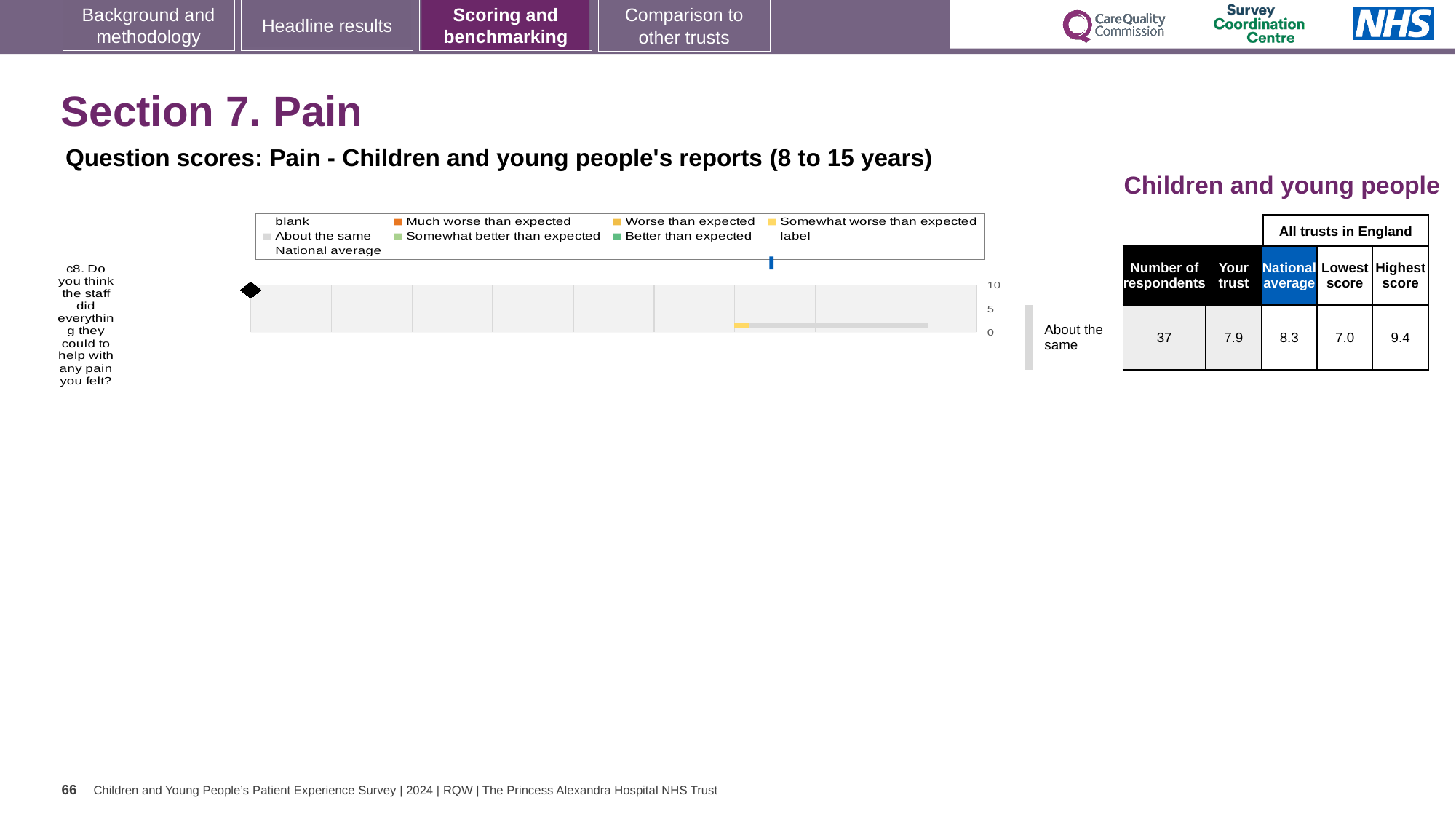
According to the table beside the chart, what is the lowest score among all trusts in England for question c8? 7.0 What is the highest value shown on the chart's axis? 10 According to the table beside the chart, what is the national average score for question c8? 8.3 How many questions (categories) are plotted in the chart? 1 Which is larger for question c8: the 'Your trust' score or the national average? national average According to the table beside the chart, what is the 'Your trust' score for question c8? 7.9 According to the table beside the chart, what is the highest score among all trusts in England for question c8? 9.4 What kind of chart is shown on the slide? bar chart What colour does the legend use for 'Much worse than expected'? orange Which benchmark category is shown next to the chart for question c8? About the same According to the table beside the chart, how many respondents answered question c8? 37